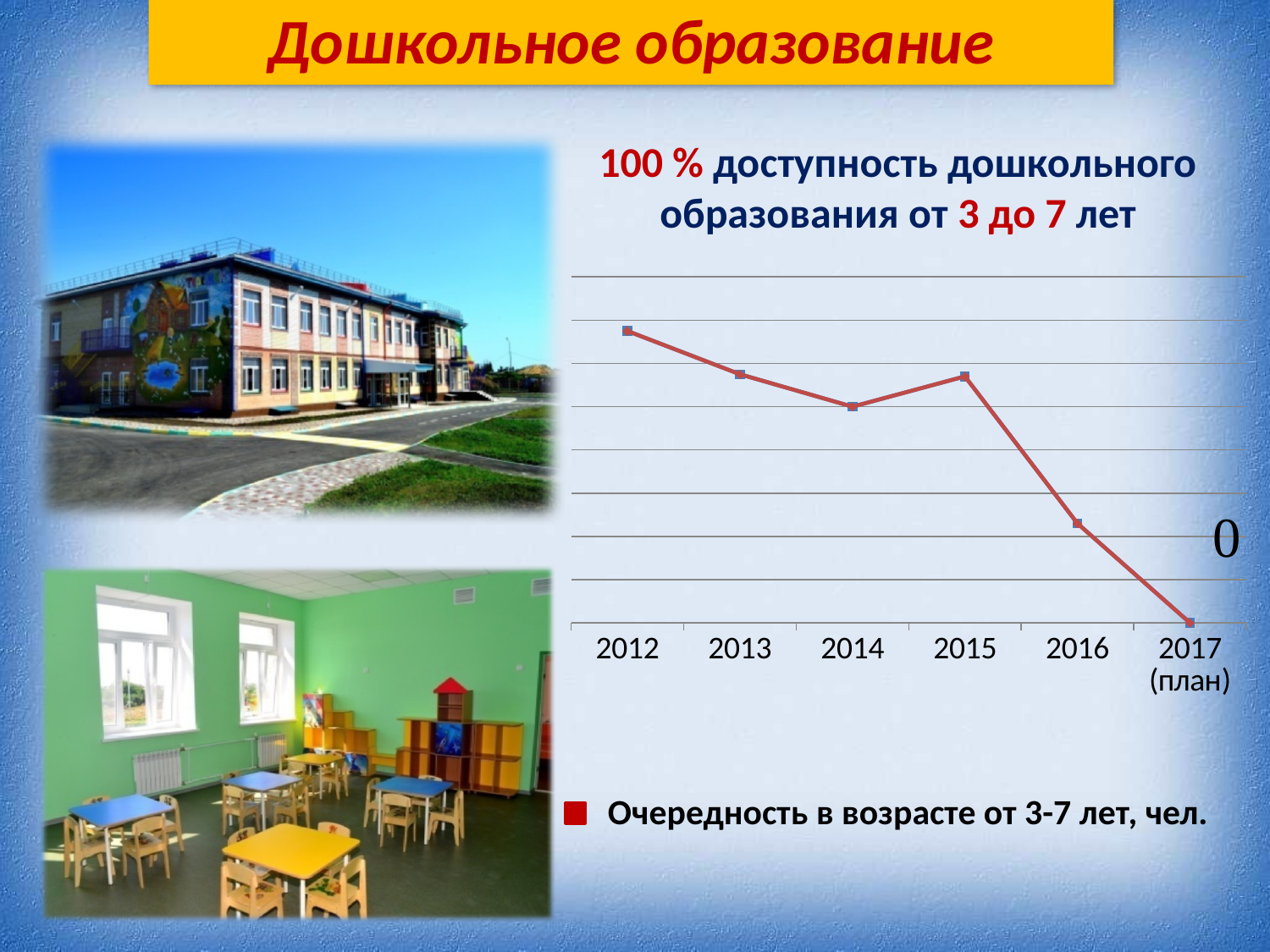
How many series does the legend of the chart list? 1 Which year has the lowest value on the chart? 2017 (план) Which is larger on the chart, the value for 2014 or the value for 2016? 2014 Which is larger on the chart, the value for 2015 or the value for 2016? 2015 What series name does the legend of the chart show? Очередность в возрасте от 3-7 лет, чел. What is the value for 2017 (план) on the chart? 0 How many data points are plotted on the line chart? 6 What colour is the line plotted on the chart? red What kind of chart is shown on the slide? line chart Which is larger on the chart, the value for 2013 or the value for 2014? 2013 Which year has the highest value on the chart? 2012 Do the values on the chart generally rise or fall from 2012 to 2017 (план)? fall